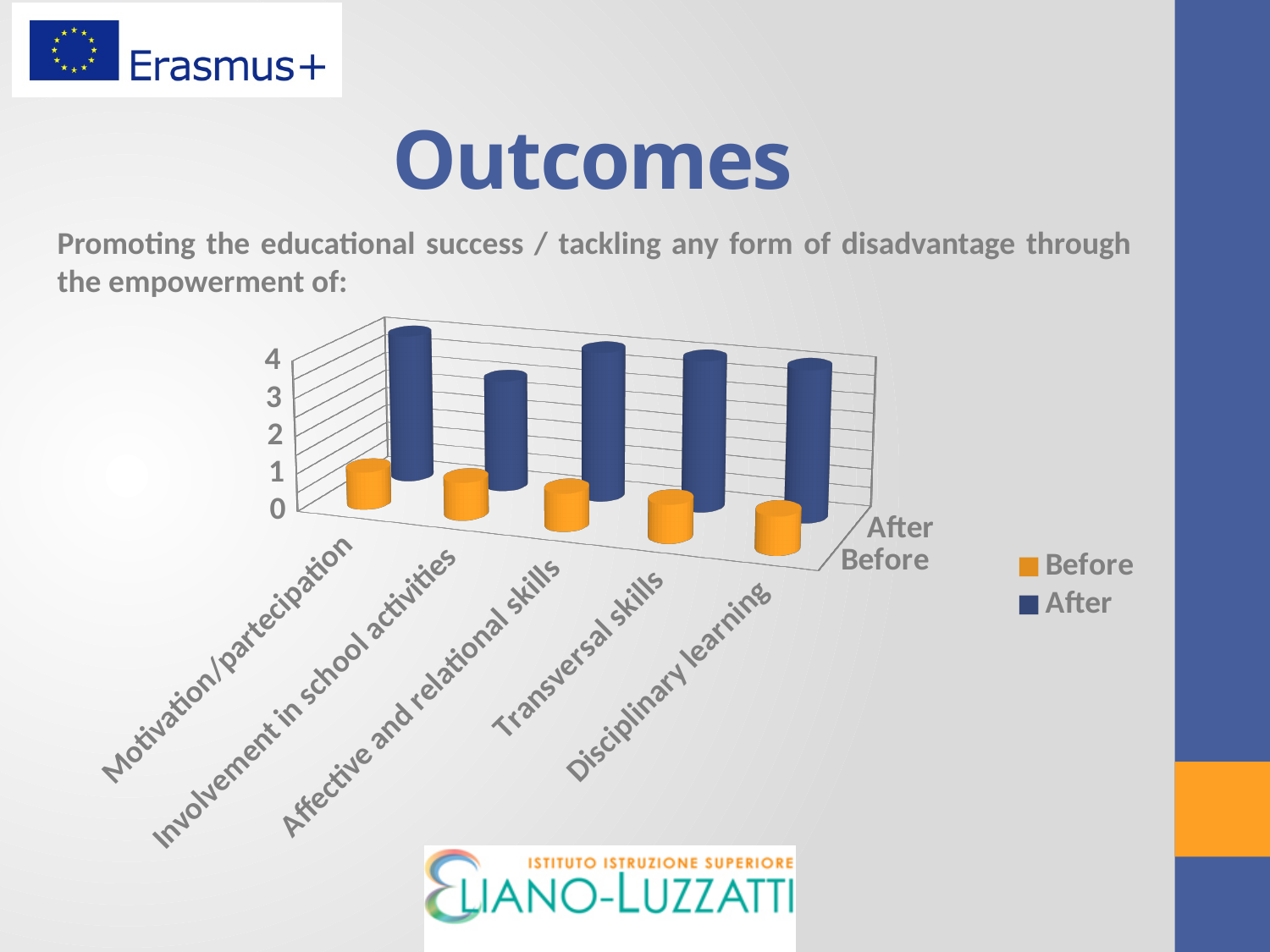
Is the After value for Motivation/partecipation greater or less than 2? greater How many series does the chart's legend list? 2 Is the After value for Involvement in school activities greater or less than 2? greater Which colour represents the 'After' series in the chart? blue Is the Before value for Motivation/partecipation greater or less than 2? less For Motivation/partecipation, which is larger: the Before value or the After value? After What are the two series named in the chart's legend? Before and After For Disciplinary learning, which is larger: the Before value or the After value? After Which category has the lowest After value? Involvement in school activities What kind of chart is shown on the slide? bar chart How many categories are shown on the x axis of the chart? 5